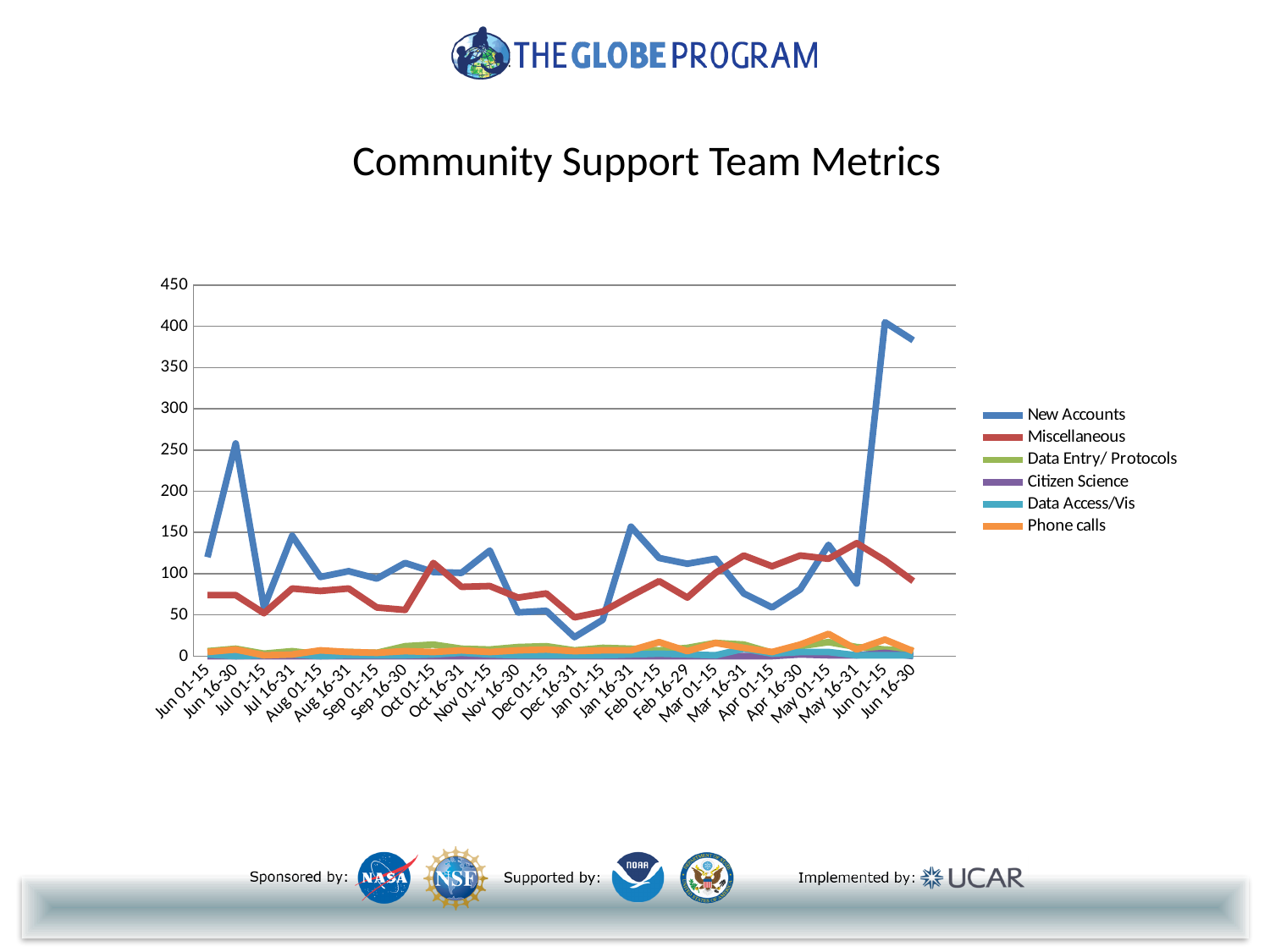
What kind of chart is shown on the slide? line chart Is the value for New Accounts at the second Jun 01-15 (near the right end) greater or less than 350? greater At which period does the New Accounts series reach its lowest value? Dec 16-31 Is the value for Miscellaneous at May 16-31 greater or less than 100? greater Which series is drawn in blue? New Accounts At which period does the New Accounts series reach its highest value? Jun 01-15 (the second one, near the right end) Is the value for New Accounts at Dec 16-31 greater or less than 50? less How many time periods are plotted along the x axis? 26 How many series does the legend list? 6 At May 16-31, which is larger: New Accounts or Miscellaneous? Miscellaneous What is the title of the chart? Community Support Team Metrics